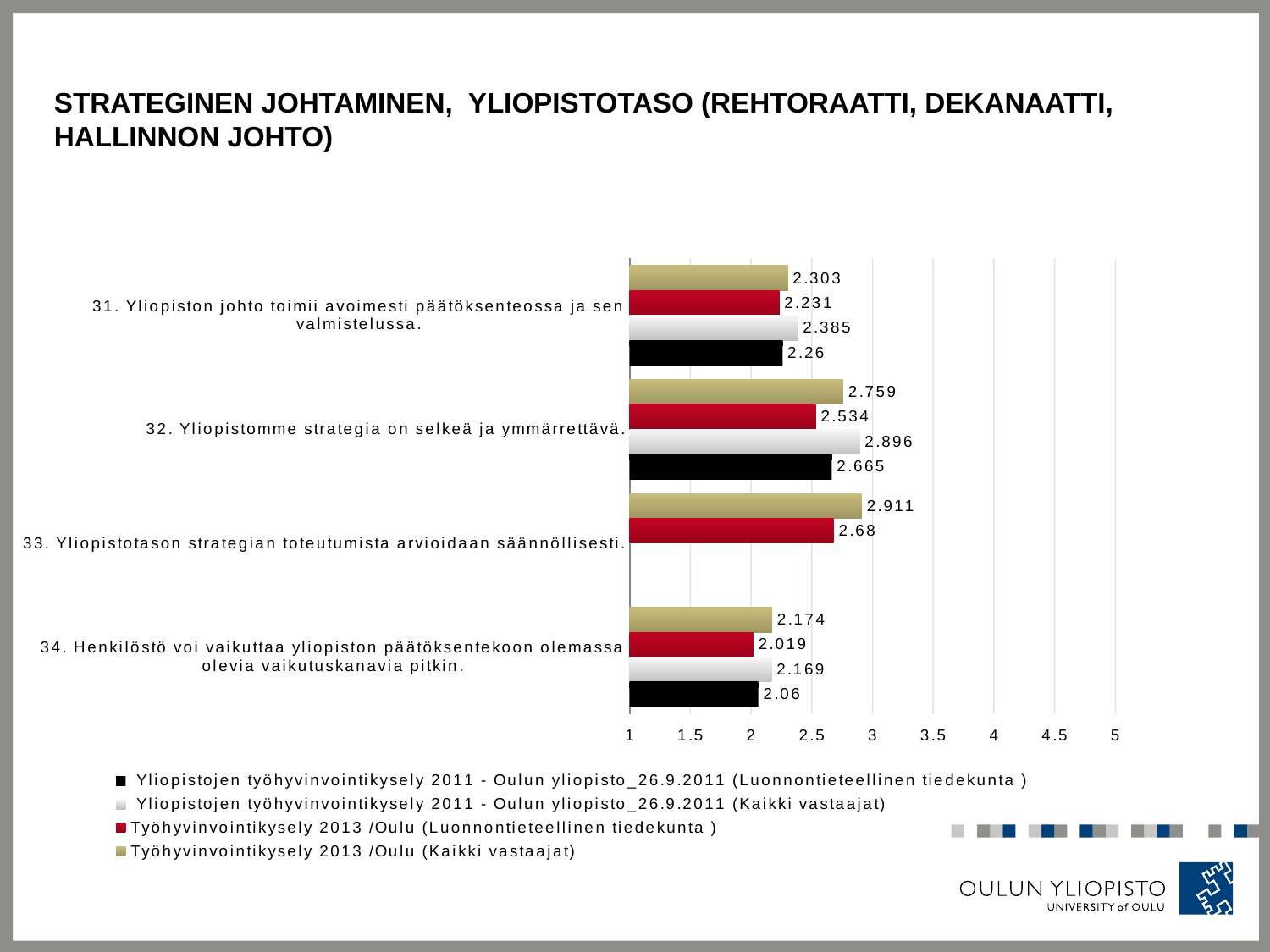
What is the difference between the 2011 'Kaikki vastaajat' value (2.896) and the 2013 'Kaikki vastaajat' value (2.759) for item 32? 0.137 What is the value for 'Yliopistojen työhyvinvointikysely 2011 - Oulun yliopisto_26.9.2011 (Luonnontieteellinen tiedekunta)' for item 34 (Henkilöstö voi vaikuttaa yliopiston päätöksentekoon)? 2.06 Is the value for 'Työhyvinvointikysely 2013 /Oulu (Kaikki vastaajat)' for item 34 greater or less than 2.5? less Which item has the lowest value for the 'Työhyvinvointikysely 2013 /Oulu (Luonnontieteellinen tiedekunta)' series? 34. Henkilöstö voi vaikuttaa yliopiston päätöksentekoon olemassa olevia vaikutuskanavia pitkin. Which item is missing bars for the two 2011 survey series? 33. Yliopistotason strategian toteutumista arvioidaan säännöllisesti. Which item has the highest value for the 'Työhyvinvointikysely 2013 /Oulu (Kaikki vastaajat)' series? 33. Yliopistotason strategian toteutumista arvioidaan säännöllisesti. What is the value for 'Työhyvinvointikysely 2013 /Oulu (Luonnontieteellinen tiedekunta)' for item 32 (Yliopistomme strategia on selkeä ja ymmärrettävä)? 2.534 What is the value for 'Työhyvinvointikysely 2013 /Oulu (Kaikki vastaajat)' for item 33 (Yliopistotason strategian toteutumista arvioidaan säännöllisesti)? 2.911 How many question categories are shown on the y axis of the chart? 4 What kind of chart is shown on the slide? bar chart How many series does the legend list? 4 For item 31, which is larger: the 2011 'Kaikki vastaajat' value or the 2013 'Luonnontieteellinen tiedekunta' value? 2011 Kaikki vastaajat (2.385)